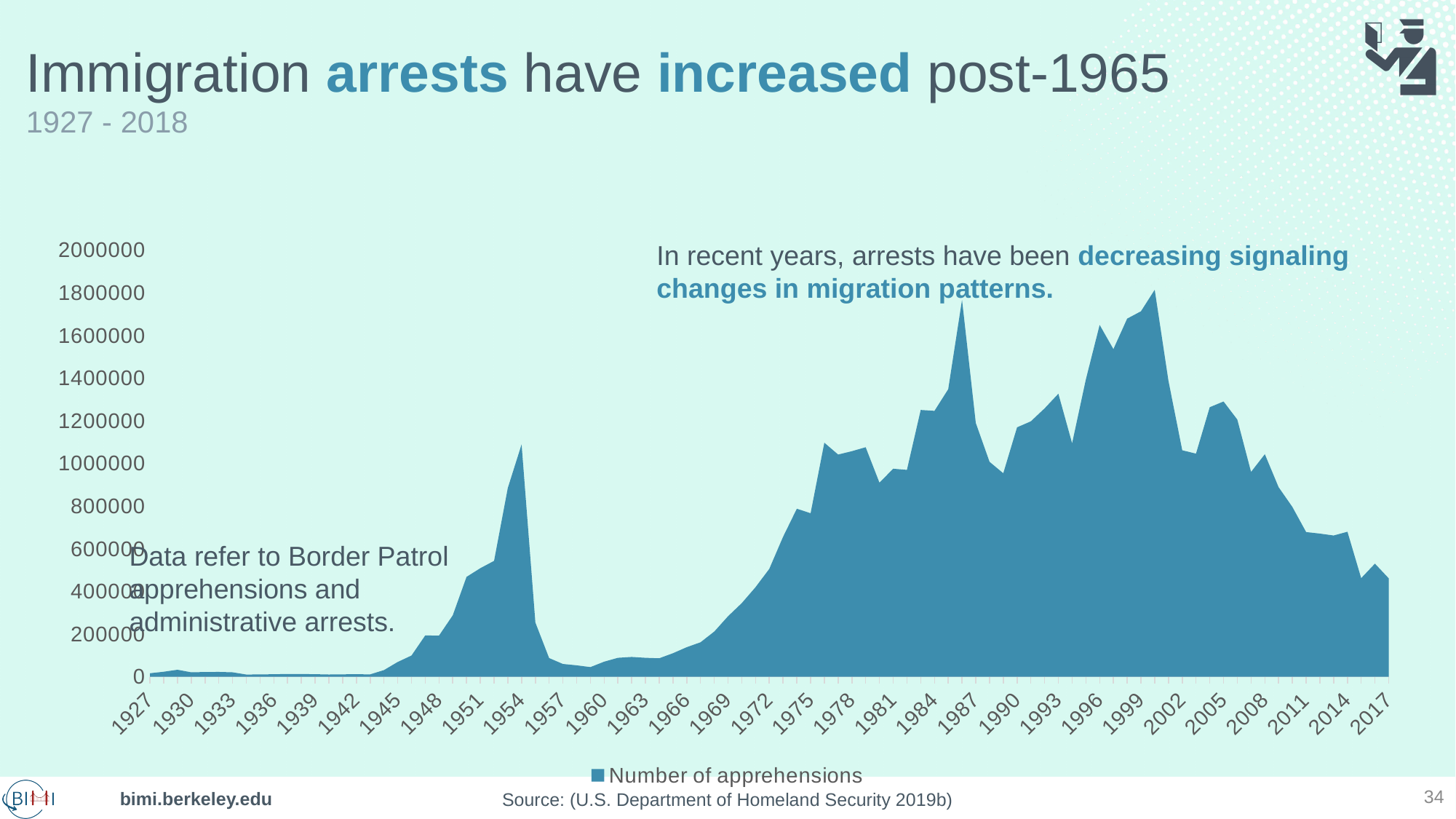
Which year has the larger value, 1986 or 1954? 1986 Do the values rise or fall from 2008 to 2017? fall Is the value for 2017 greater or less than 200000? greater How many series does the legend list? 1 Is the value for 1954 greater or less than 800000? greater Which year has the larger value, 1954 or 1975? 1954 What is the title of the chart on the slide? Immigration arrests have increased post-1965 What kind of chart is shown on the slide? Area chart Is the value for 1960 greater or less than 200000? less What is the series name shown in the legend? Number of apprehensions